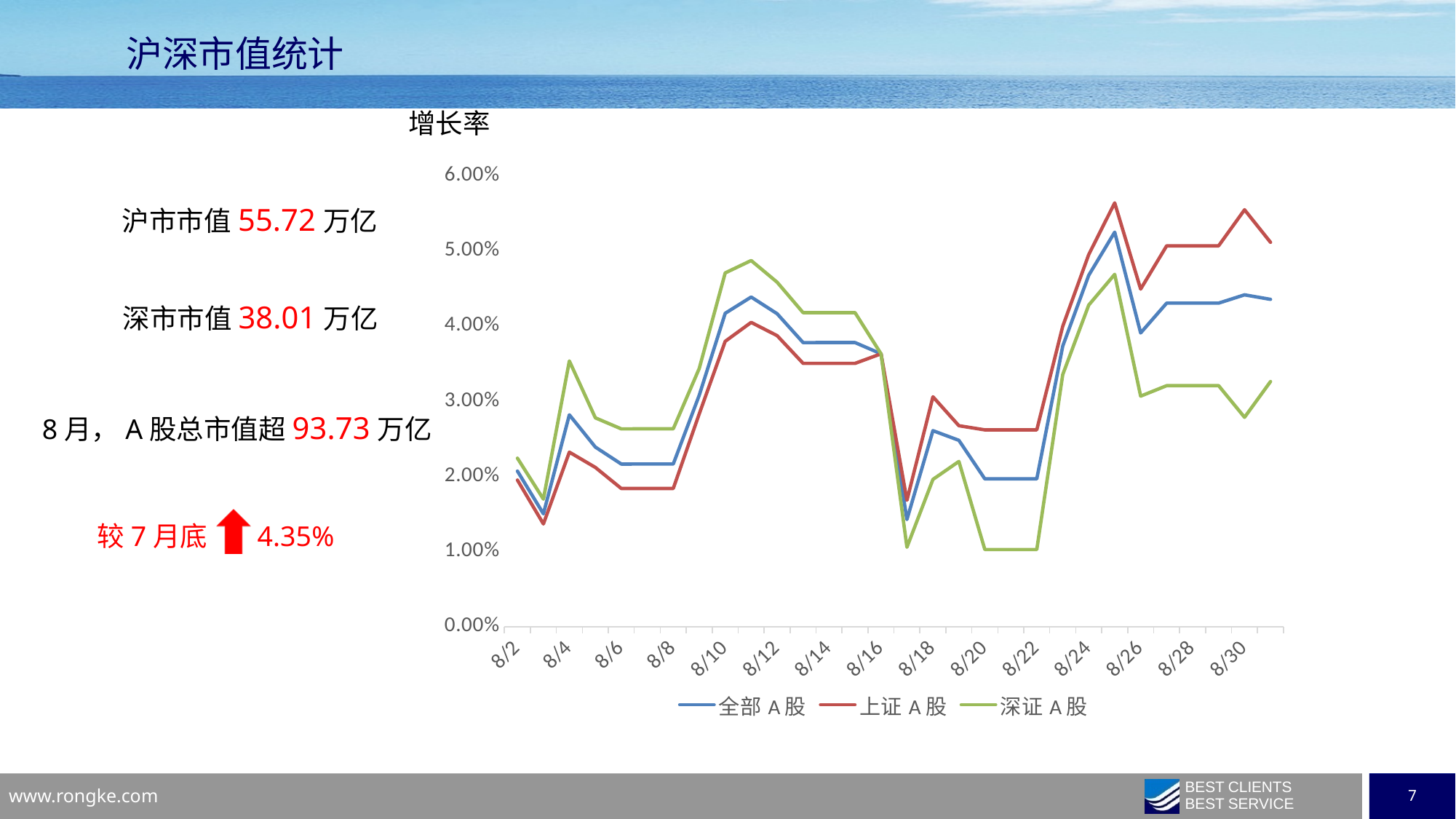
On 8/10, which series has the higher value, 上证 A 股 or 深证 A 股? 深证 A 股 Which series is drawn in green in the chart? 深证 A 股 How many date labels are shown on the x axis of the chart? 15 What kind of chart is shown on the slide? line chart Is the value for 深证 A 股 on 8/20 greater or less than 2.00%? less What is the title of the chart? 增长率 Is the value for 深证 A 股 on 8/12 greater or less than 4.00%? greater Is the value for 全部 A 股 on 8/22 greater or less than 3.00%? less On 8/20, which series has the higher value, 上证 A 股 or 深证 A 股? 上证 A 股 Which series reaches the highest value anywhere on the chart? 上证 A 股 How many series does the chart legend list? 3